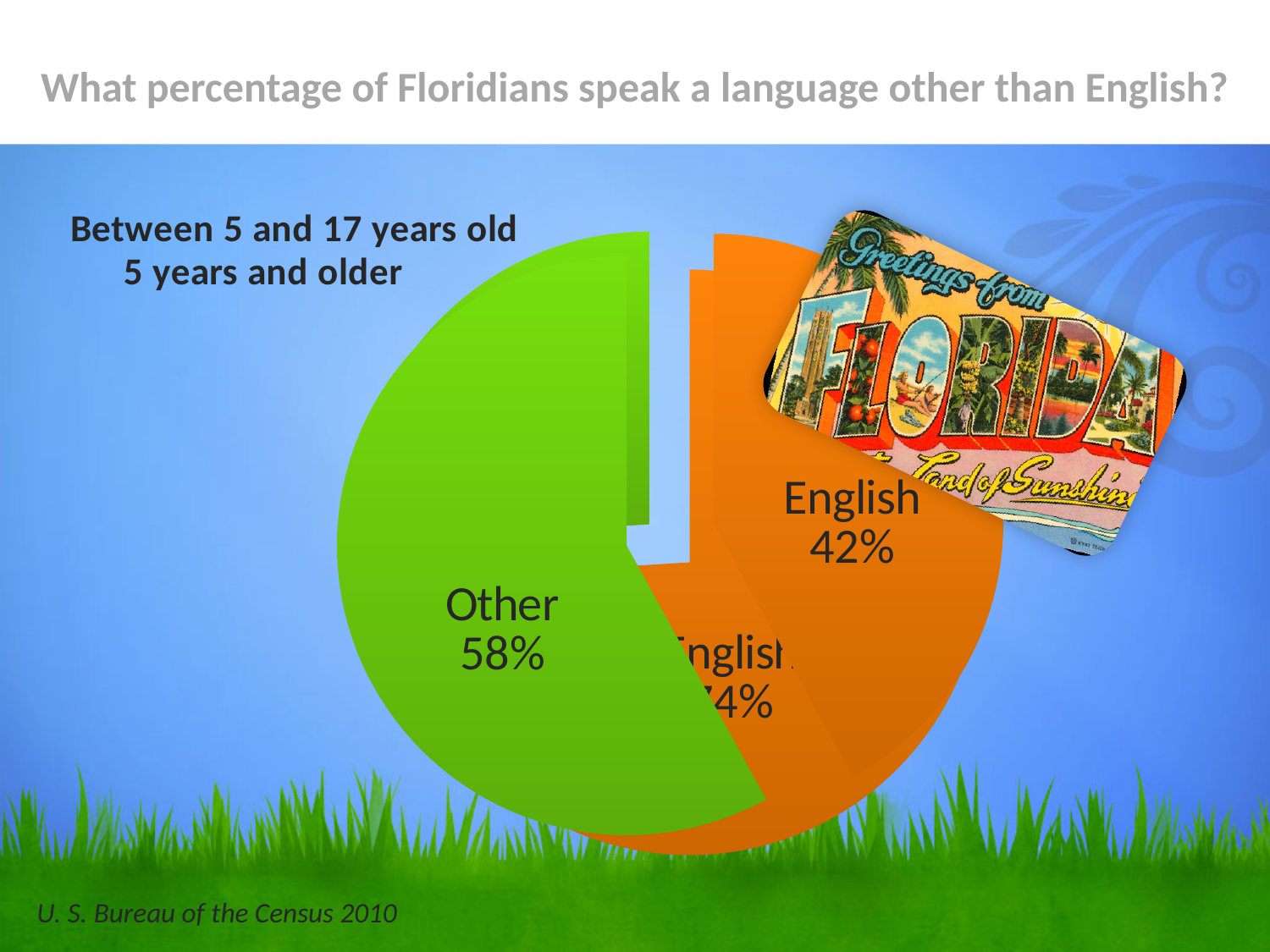
How many slices does the front pie chart have? 2 On the front pie chart, what percentage is shown for the Other slice? 58% What colour is the Other slice on the front pie chart? Green What is the title of the slide containing the pie charts? What percentage of Floridians speak a language other than English? On the front pie chart, is the value for Other greater or less than 50%? greater What kind of chart is used on this slide? Pie chart On the front pie chart, which slice is the largest? Other On the front pie chart, which slice is larger, Other or English? Other On the front pie chart, what percentage is shown for the English slice? 42% On the front pie chart, which slice is the smallest? English What source is cited for the chart data on the slide? U. S. Bureau of the Census 2010 On the front pie chart, what is the difference in percentage points between the Other slice and the English slice? 16